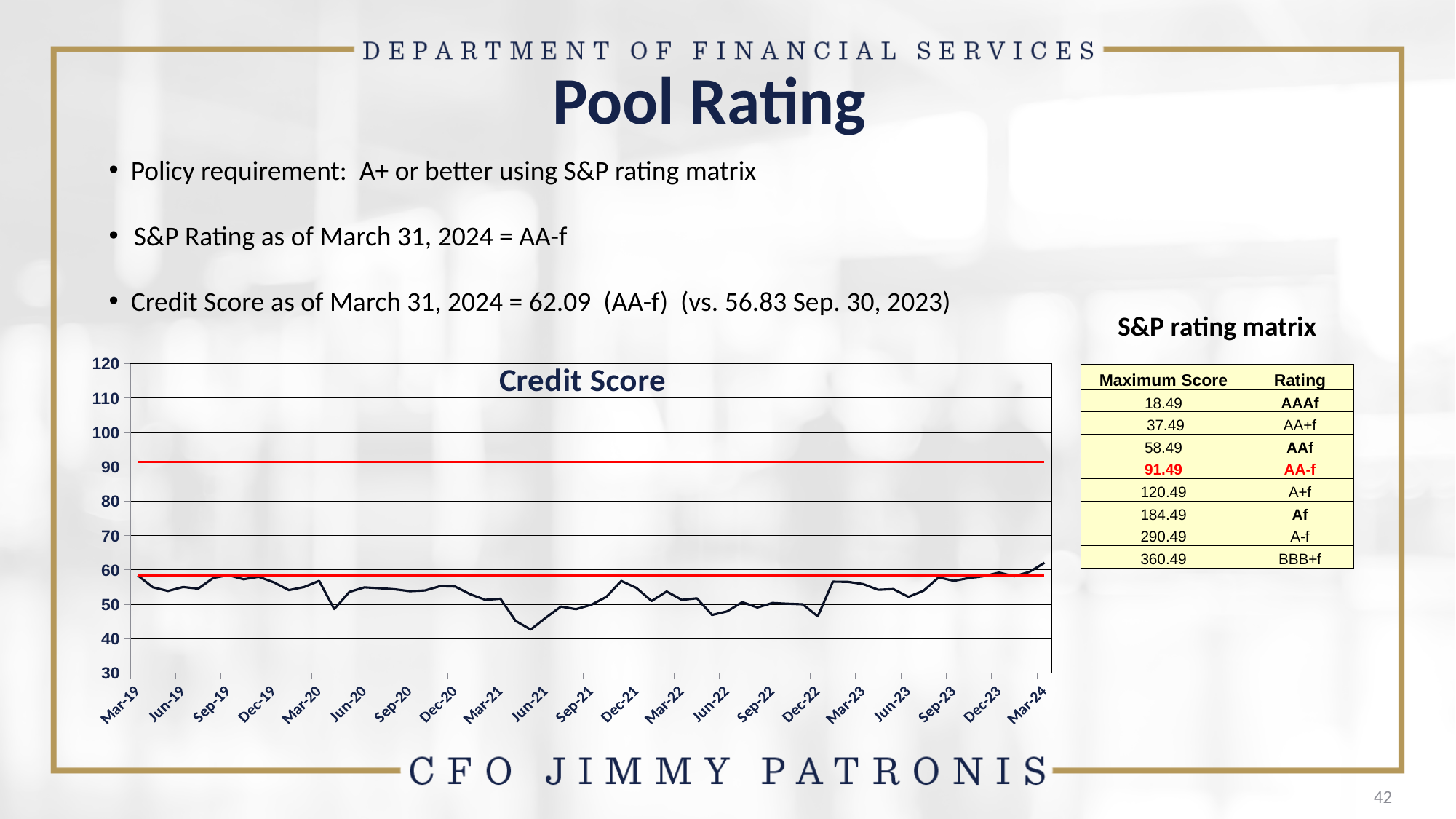
What is the credit score as of March 31, 2024 (the Mar-24 point on the chart)? 62.09 In the Credit Score chart, is the value for Mar-24 greater or less than 60? greater In the Credit Score chart, is the value for Mar-19 greater or less than 60? less In the Credit Score chart, which is larger, the value for Dec-21 or the value for Jun-22? Dec-21 In the Credit Score chart, does the credit score rise or fall from Dec-22 to Mar-24? rise What kind of chart is the Credit Score chart? line chart What is the title of the chart on the slide? Credit Score How many date labels are shown on the x axis of the Credit Score chart? 21 In the Credit Score chart, which x-axis date has the highest credit score? Mar-24 In the Credit Score chart, is the value for Jun-22 greater or less than 50? less